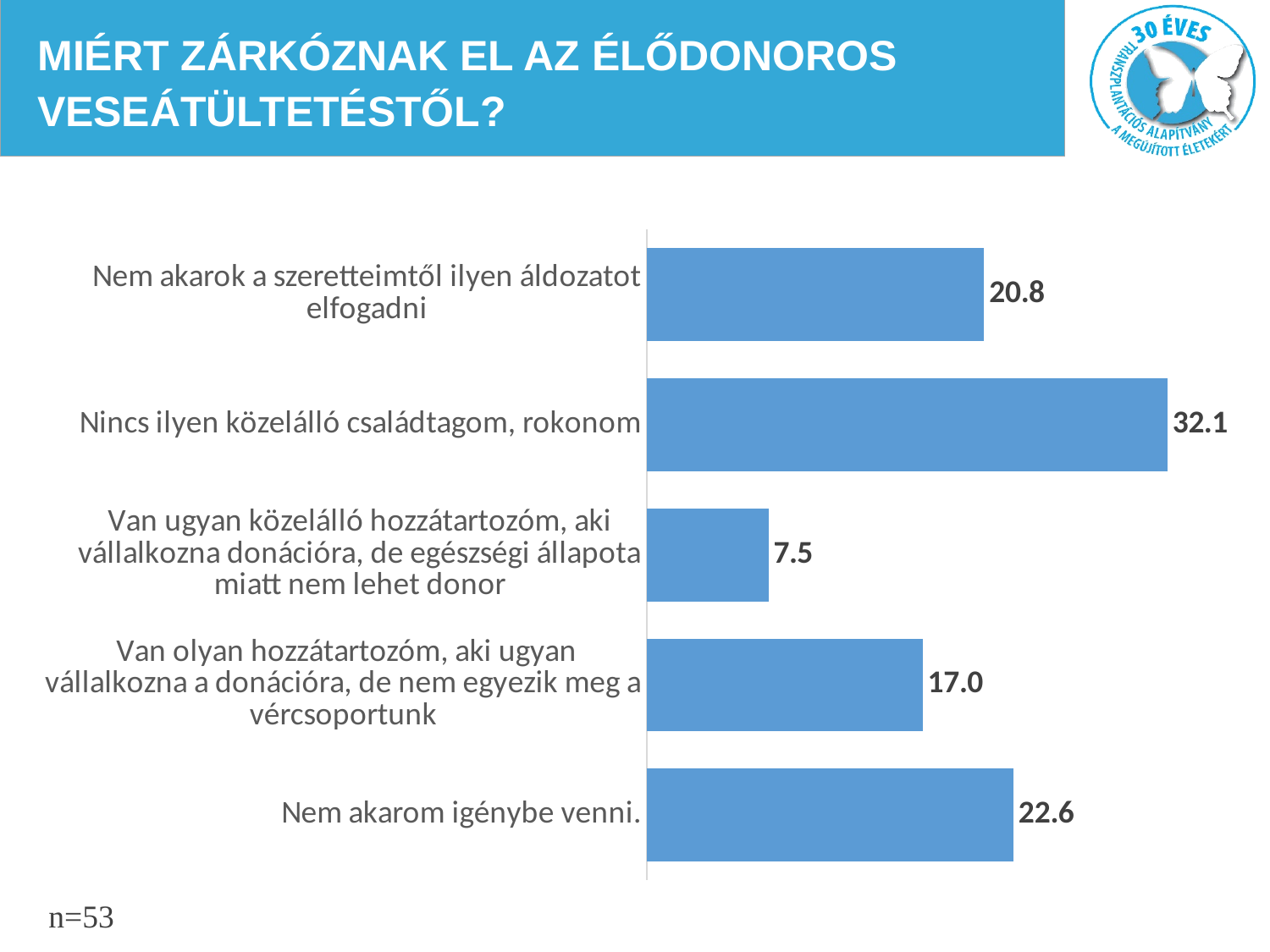
What is the difference between the values for "Nem akarom igénybe venni." and "Nem akarok a szeretteimtől ilyen áldozatot elfogadni"? 1.8 What kind of chart is shown on the slide? Bar chart What is the value for the category about a relative who would donate but whose health prevents it ("Van ugyan közelálló hozzátartozóm...")? 7.5 What is the value for "Nincs ilyen közelálló családtagom, rokonom"? 32.1 Which category has the highest value? Nincs ilyen közelálló családtagom, rokonom Which is larger: the value for "Nem akarok a szeretteimtől ilyen áldozatot elfogadni" or the value for the category about a relative with a non-matching blood type ("Van olyan hozzátartozóm...")? Nem akarok a szeretteimtől ilyen áldozatot elfogadni What is the difference between the values for "Nincs ilyen közelálló családtagom, rokonom" and "Nem akarom igénybe venni."? 9.5 What sample size (n) is stated on the slide? n=53 What is the value for "Nem akarom igénybe venni."? 22.6 How many categories are shown in the chart? 5 Which category has the lowest value? Van ugyan közelálló hozzátartozóm, aki vállalkozna donációra, de egészségi állapota miatt nem lehet donor What is the value for "Nem akarok a szeretteimtől ilyen áldozatot elfogadni"? 20.8